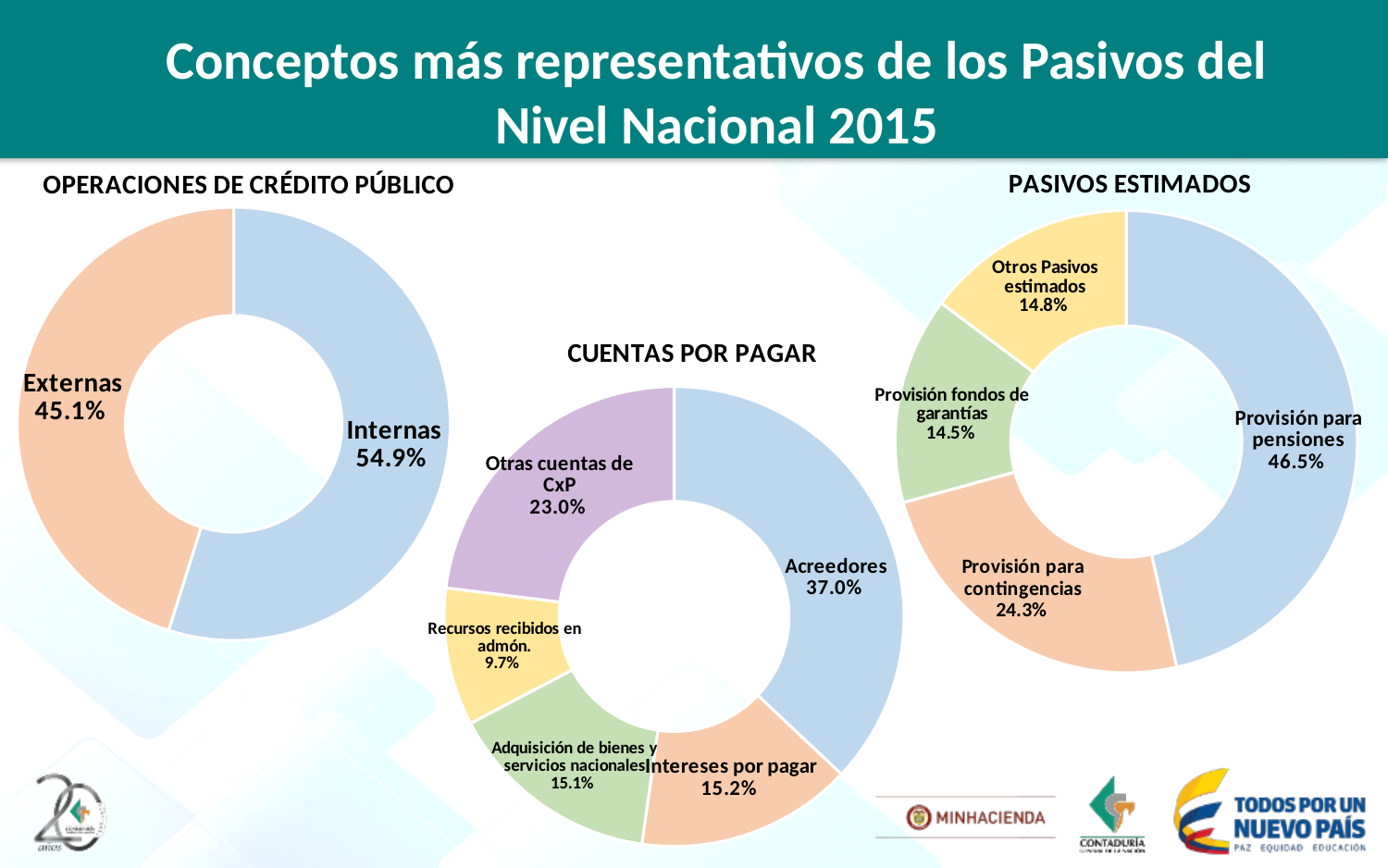
In the OPERACIONES DE CRÉDITO PÚBLICO chart, what share is Internas? 54.9% In the CUENTAS POR PAGAR chart, which category has the smallest share? Recursos recibidos en admón. In the CUENTAS POR PAGAR chart, what share is Acreedores? 37.0% How many categories are shown in the PASIVOS ESTIMADOS chart? 4 In the PASIVOS ESTIMADOS chart, what share is Provisión para contingencias? 24.3% In the OPERACIONES DE CRÉDITO PÚBLICO chart, what is the difference between Internas and Externas? 9.8% How many categories are shown in the CUENTAS POR PAGAR chart? 5 In the PASIVOS ESTIMADOS chart, which category has the largest share? Provisión para pensiones In the OPERACIONES DE CRÉDITO PÚBLICO chart, which slice is larger, Externas or Internas? Internas What type of chart is the PASIVOS ESTIMADOS chart? Donut (pie) chart In the CUENTAS POR PAGAR chart, what is the difference between Acreedores and Otras cuentas de CxP? 14.0% In the CUENTAS POR PAGAR chart, which category has the largest share? Acreedores